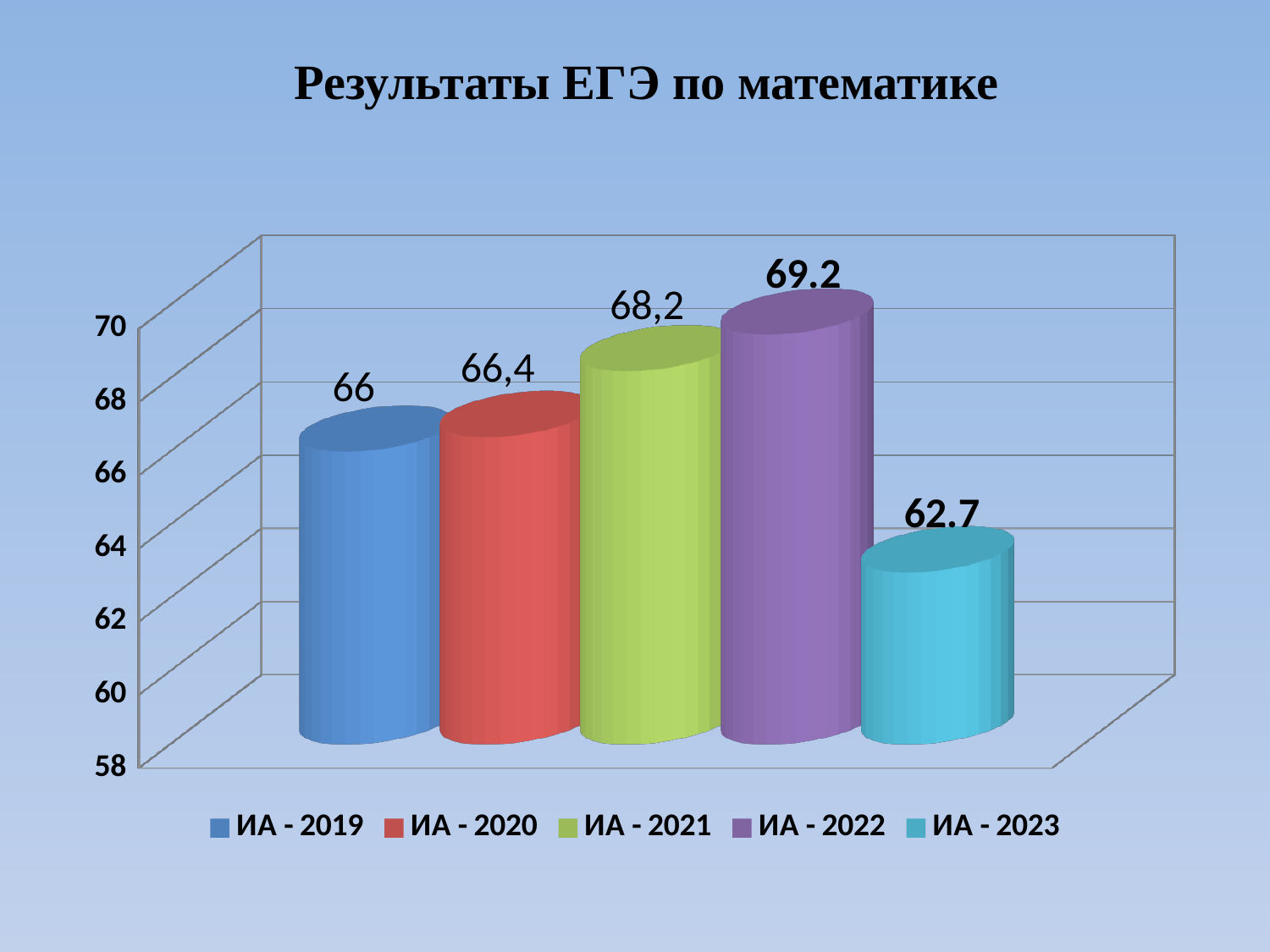
Is the value for ИА - 2023 greater or less than 64? less What is the title of the chart? Результаты ЕГЭ по математике Which series has the highest value? ИА - 2022 What is the value for ИА - 2019? 66 Which is larger, the value for ИА - 2021 or the value for ИА - 2020? ИА - 2021 Which series has the lowest value? ИА - 2023 What kind of chart is shown on the slide? bar chart How many series does the legend list? 5 What is the value for ИА - 2023? 62.7 What is the difference between the values for ИА - 2020 and ИА - 2019? 0,4 What is the value for ИА - 2021? 68,2 What is the difference between the values for ИА - 2022 and ИА - 2023? 6.5